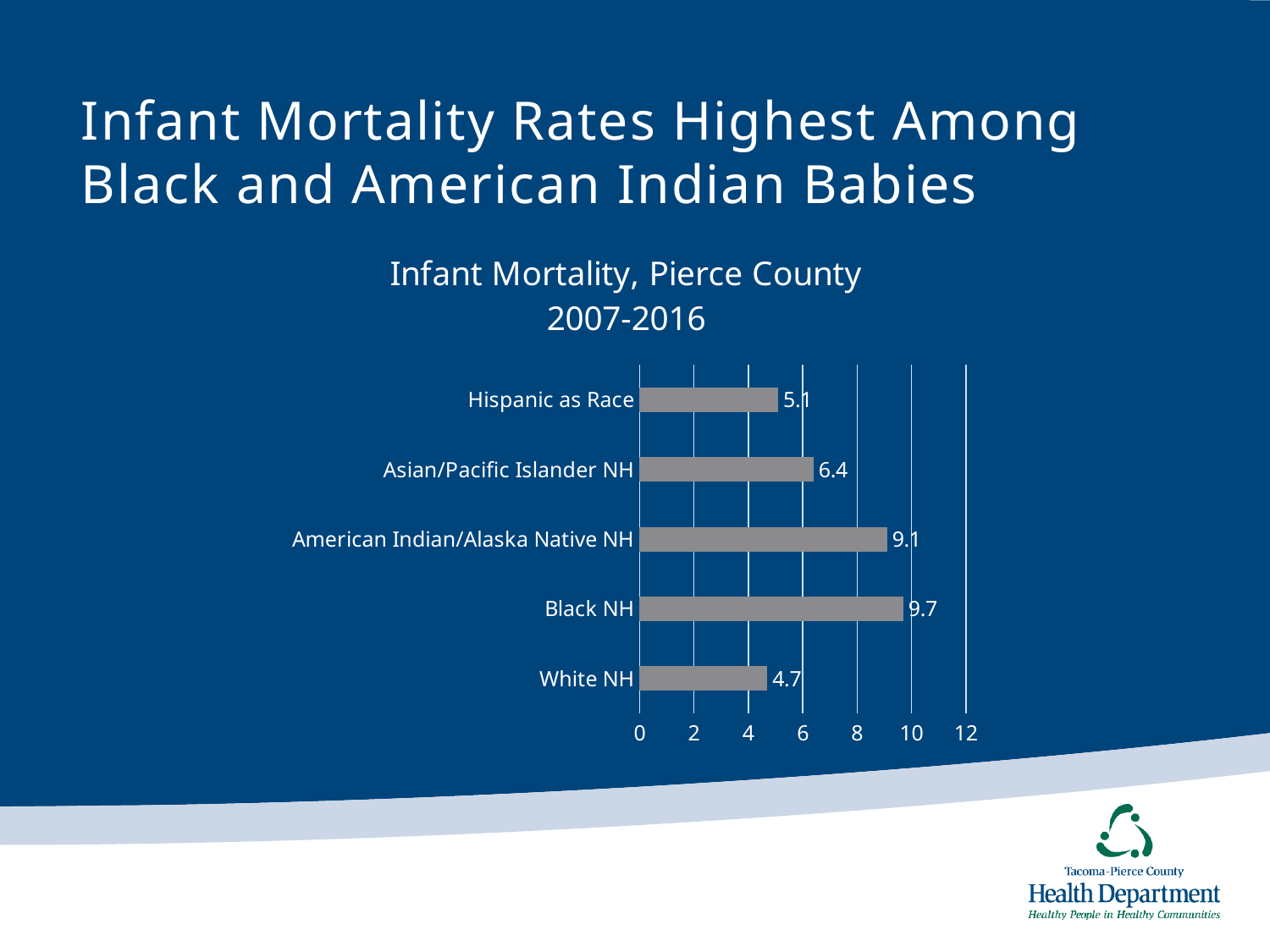
What is the difference between the infant mortality rates for American Indian/Alaska Native NH and Asian/Pacific Islander NH? 2.7 What is the infant mortality rate for Black NH? 9.7 Which category has the highest infant mortality rate? Black NH How many categories are shown in the chart? 5 What is the title of the chart? Infant Mortality, Pierce County 2007-2016 What is the difference between the infant mortality rates for Black NH and White NH? 5.0 What is the infant mortality rate for Asian/Pacific Islander NH? 6.4 Which category has the lowest infant mortality rate? White NH What is the infant mortality rate for Hispanic as Race? 5.1 What is the infant mortality rate for White NH? 4.7 What kind of chart is shown on the slide? Bar chart Which has a higher infant mortality rate, Asian/Pacific Islander NH or Hispanic as Race? Asian/Pacific Islander NH